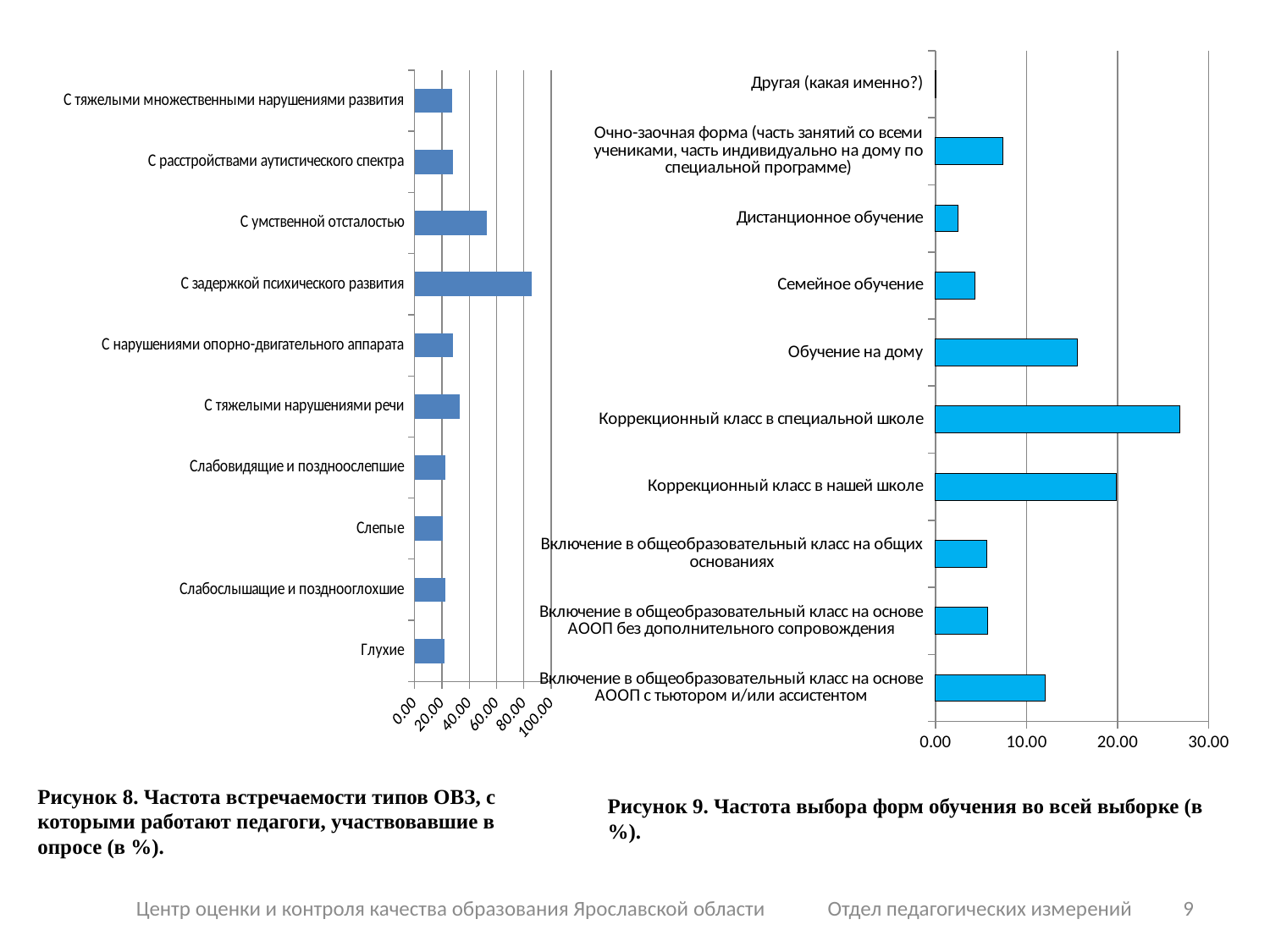
How many categories are shown in the left chart (Рисунок 8)? 10 What kind of chart is the right chart (Рисунок 9)? Bar chart In the left chart (Рисунок 8), which is larger: the value for С умственной отсталостью or the value for Глухие? С умственной отсталостью In the left chart (Рисунок 8), which category has the highest value? С задержкой психического развития In the right chart (Рисунок 9), is the value for Дистанционное обучение greater or less than 10.00? less In the right chart (Рисунок 9), which category has the highest value? Коррекционный класс в специальной школе In the right chart (Рисунок 9), which category has the lowest value? Другая (какая именно?) In the right chart (Рисунок 9), which is larger: the value for Обучение на дому or the value for Семейное обучение? Обучение на дому In the right chart (Рисунок 9), is the value for Обучение на дому greater or less than 10.00? greater In the left chart (Рисунок 8), is the value for С умственной отсталостью greater or less than 40.00? greater How many categories are shown in the right chart (Рисунок 9)? 10